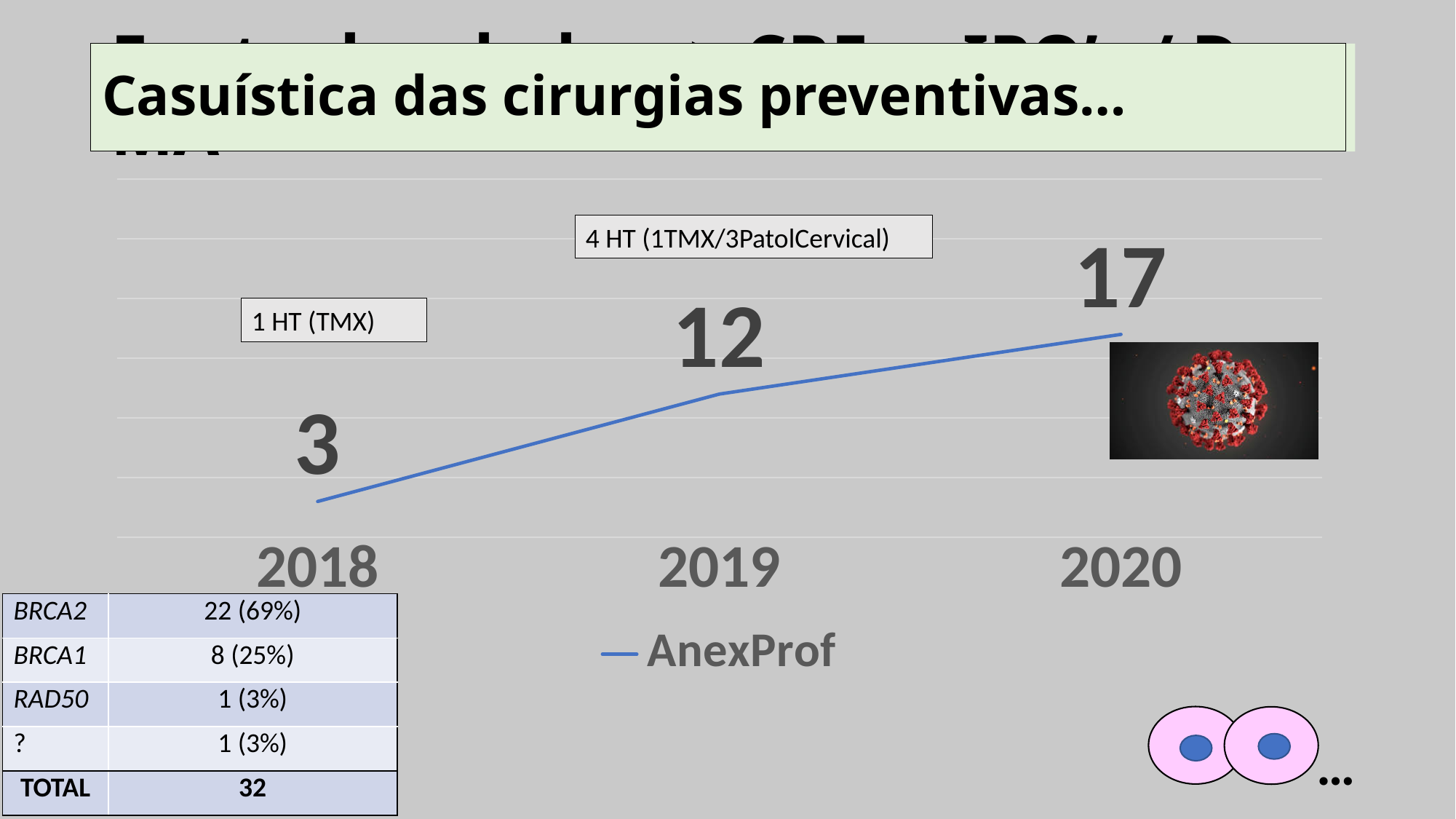
Which year has the highest value in the line chart? 2020 What is the value for 2019 in the AnexProf line chart? 12 What is the value for 2020 in the AnexProf line chart? 17 What is the difference between the values for 2019 and 2018? 9 Which is larger, the value for 2019 or the value for 2018? 2019 How many series does the legend of the chart list? 1 What kind of chart is shown on the slide? line chart Which year has the lowest value in the line chart? 2018 How many years are plotted on the x axis of the line chart? 3 What is the value for 2018 in the AnexProf line chart? 3 What is the difference between the values for 2020 and 2019? 5 Do the values rise or fall from 2018 to 2020? rise